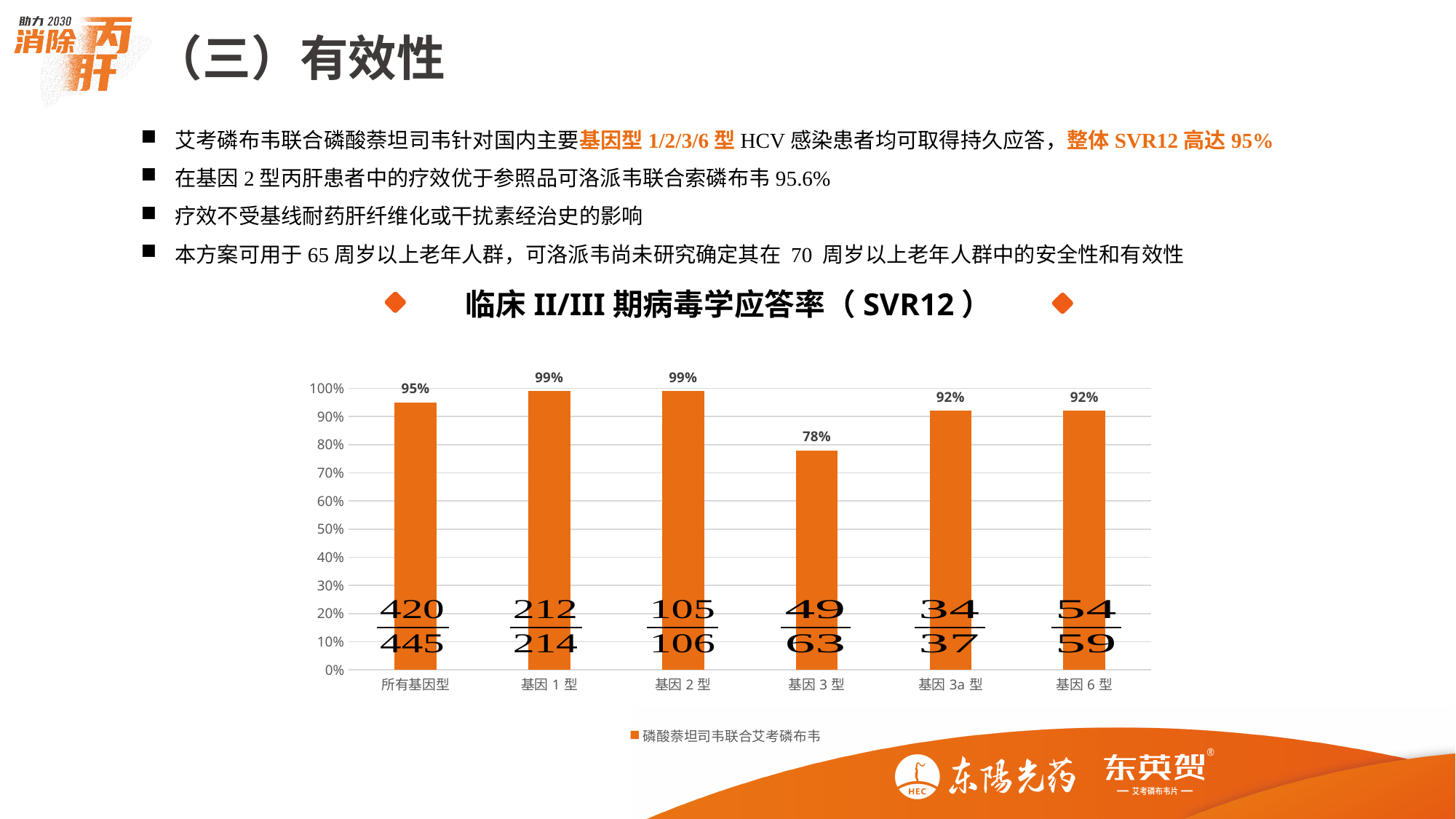
How many series does the chart legend list? 1 What kind of chart is shown on the slide? bar chart What is the SVR12 value for 基因 1 型? 99% What is the title of the chart? 临床 II/III 期病毒学应答率（SVR12） Which category has the lowest SVR12 value? 基因 3 型 What is the SVR12 value for 基因 3 型 in the chart? 78% What is the SVR12 value for 所有基因型? 95% How many categories are shown on the x axis of the chart? 6 What is the highest SVR12 value shown in the chart? 99% What is the SVR12 value for 基因 6 型? 92% What is the difference between the SVR12 values for 基因 2 型 and 基因 3 型? 21% Which has a higher SVR12 value, 基因 3a 型 or 基因 3 型? 基因 3a 型